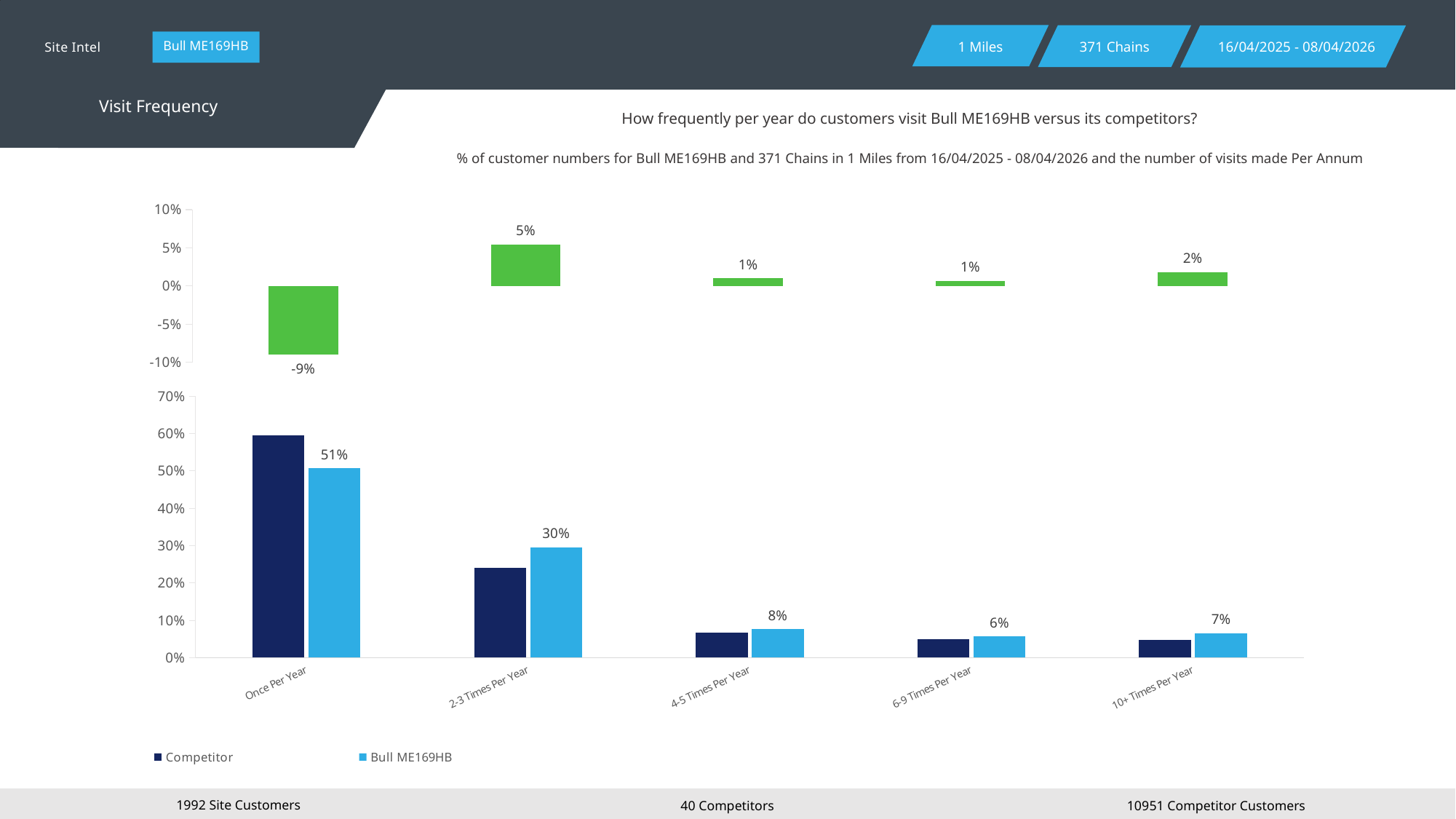
In the bottom chart, how many series does the legend list? 2 In the bottom chart, what is the value for Bull ME169HB for 2-3 Times Per Year? 30% In the top chart, what is the value shown for Once Per Year? -9% In the top chart, which category has the lowest value? Once Per Year In the bottom chart, what is the difference between the Bull ME169HB values for Once Per Year and 2-3 Times Per Year? 21% In the bottom chart, how many categories are shown on the x axis? 5 In the top chart, which category has the highest value? 2-3 Times Per Year In the bottom chart, for Once Per Year, which is larger: Competitor or Bull ME169HB? Competitor In the bottom chart, is the Competitor value for Once Per Year greater or less than 50%? greater In the bottom chart, what is the value for Bull ME169HB for Once Per Year? 51% In the top chart, what is the value shown for 2-3 Times Per Year? 5% What kind of chart is the bottom chart? bar chart